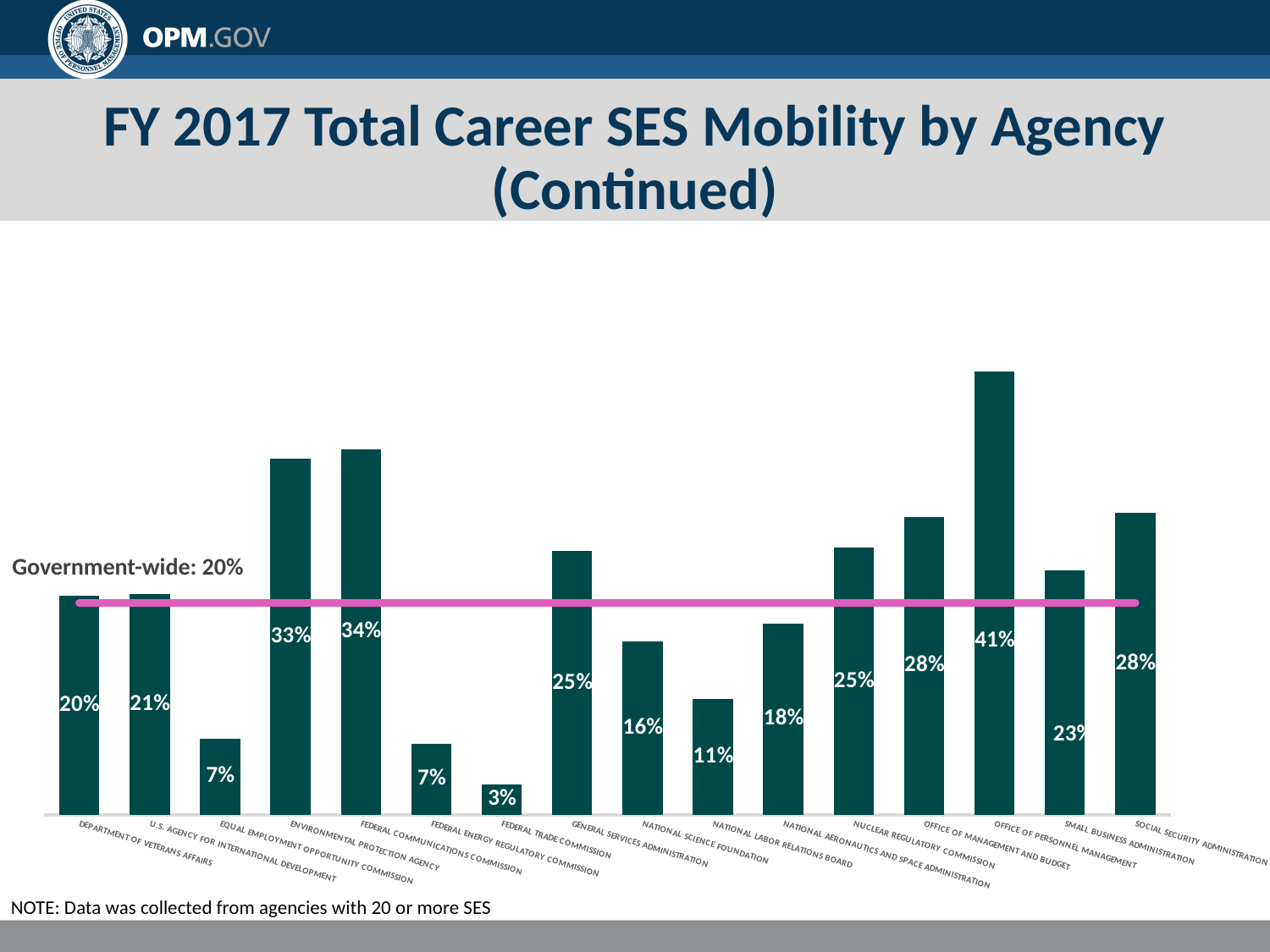
What is the value for the Office of Personnel Management? 41% What is the value for the National Science Foundation? 16% What is the difference between the Office of Personnel Management and the Social Security Administration? 13% How many agencies are shown in the chart? 16 What kind of chart is shown on the slide? Bar chart What is the value for the Federal Trade Commission? 3% What is the difference between the Federal Communications Commission and the National Labor Relations Board? 23% What is the value for the Small Business Administration? 23% What government-wide value does the horizontal line on the chart represent? 20% Which is larger, the value for the Environmental Protection Agency or the value for the General Services Administration? Environmental Protection Agency Which agency has the lowest career SES mobility? Federal Trade Commission Which agency has the highest career SES mobility? Office of Personnel Management